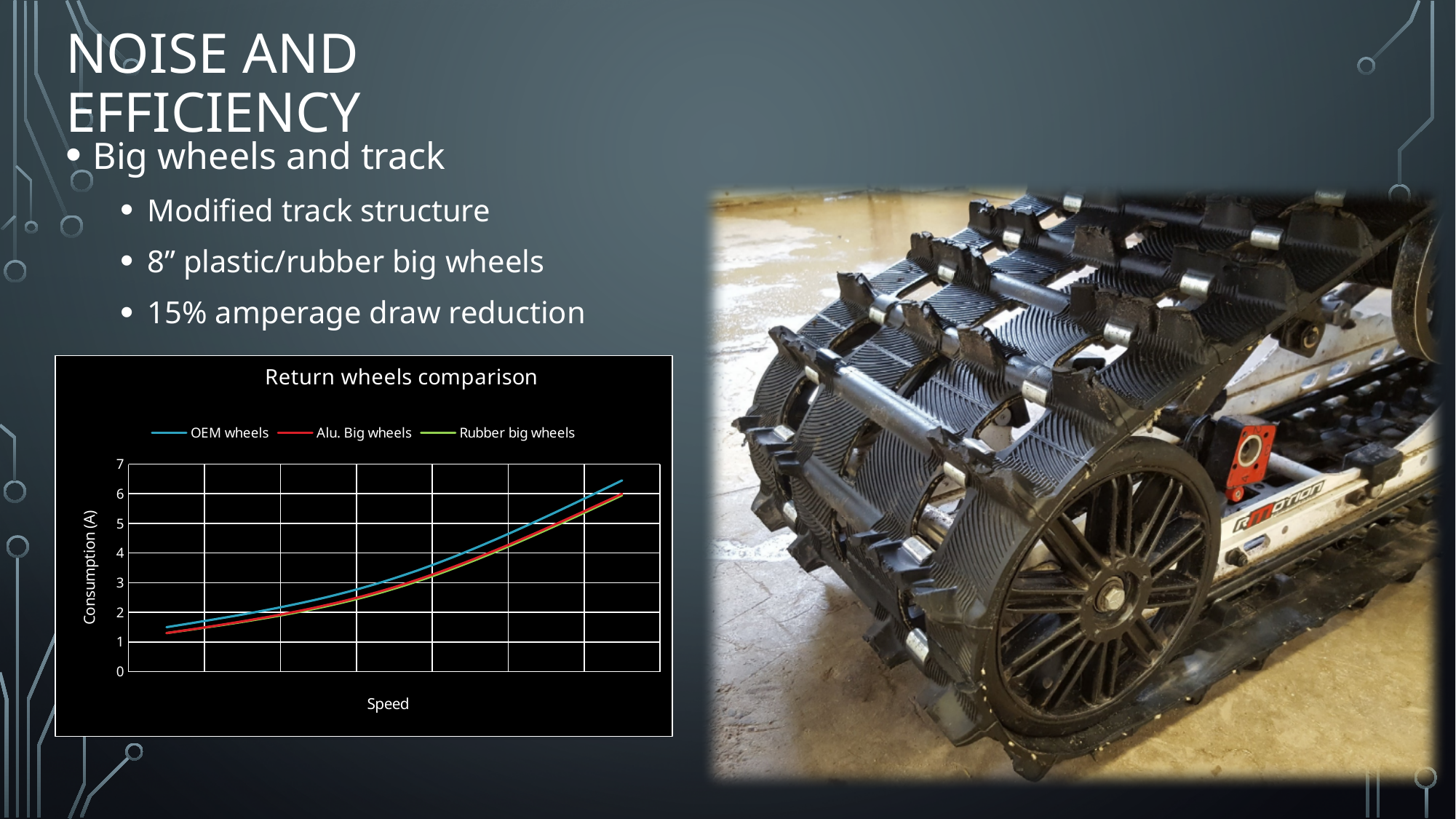
What kind of chart is shown on the slide? line chart At the right end of the chart, is the consumption for OEM wheels greater or less than 6? greater Do the consumption values rise or fall as speed increases along the x axis? rise What is the title of the chart on the slide? Return wheels comparison What is the highest value shown on the vertical axis of the chart? 7 How many series does the chart's legend list? 3 At the left end of the chart, is the consumption for Alu. Big wheels greater or less than 2? less What is the label of the vertical axis of the chart? Consumption (A) At the left end of the chart, is the consumption for OEM wheels greater or less than 2? less At the right end of the chart, which series has the higher consumption: OEM wheels or Alu. Big wheels? OEM wheels Which series reaches the highest consumption at the right end of the chart? OEM wheels